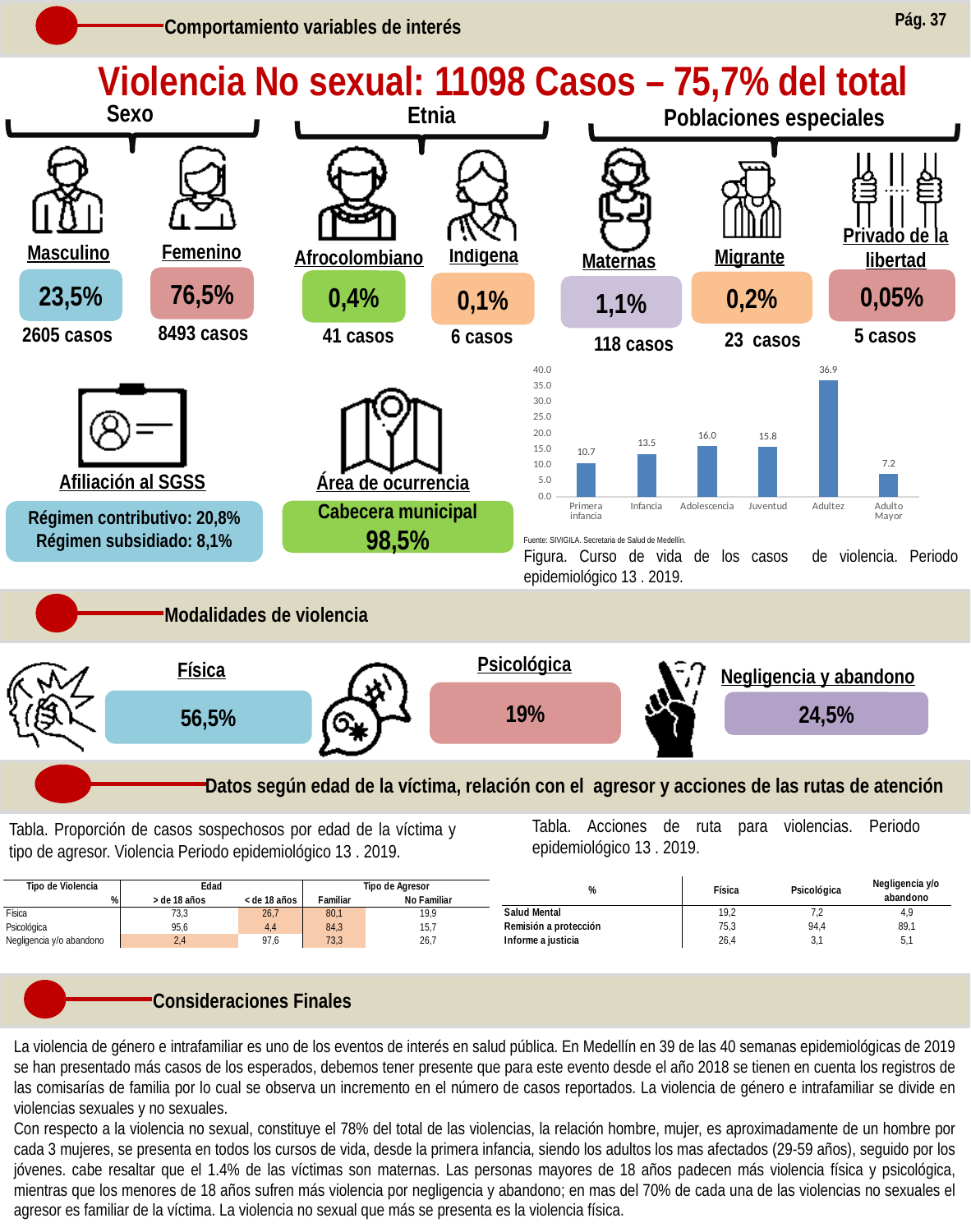
What is the source cited below the bar chart? SIVIGILA. Secretaria de Salud de Medellín. How many categories are shown on the x axis of the bar chart? 6 In the bar chart, what is the value for Adolescencia? 16.0 In the bar chart, is the value for Adultez greater or less than 35.0? greater In the bar chart, what is the value for Adultez? 36.9 Which category has the highest value in the bar chart? Adultez Which category has the lowest value in the bar chart? Adulto Mayor In the bar chart, what is the value for Primera infancia? 10.7 In the bar chart, what is the value for Adulto Mayor? 7.2 In the bar chart, what is the difference between the values for Adultez and Juventud? 21.1 In the bar chart, which is larger: the value for Infancia or the value for Primera infancia? Infancia What type of chart is shown on the slide (the 'Curso de vida' figure)? bar chart